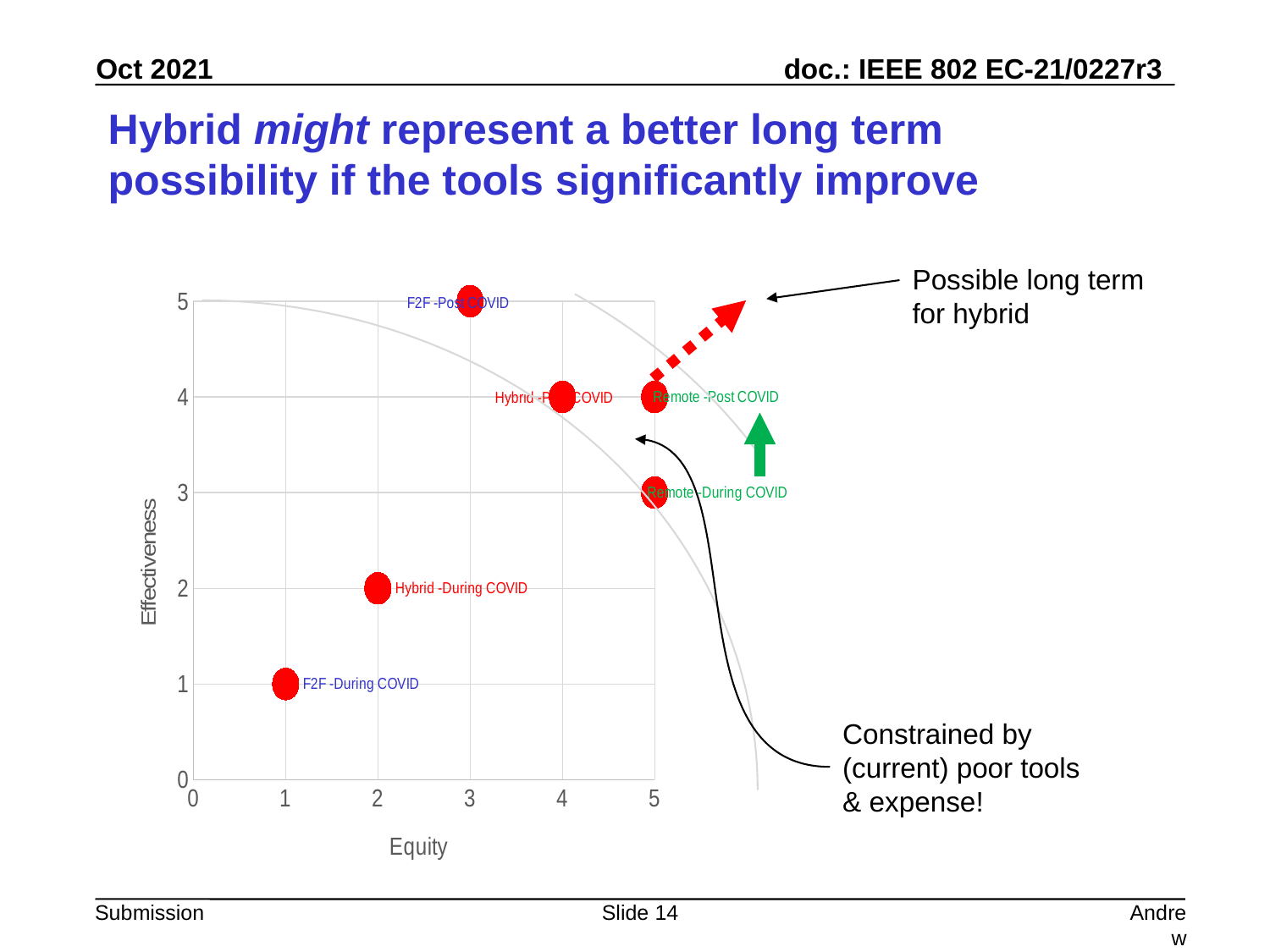
Which has the higher Effectiveness value, Hybrid -Post COVID or Hybrid -During COVID? Hybrid -Post COVID What is the Equity value for Hybrid -During COVID? 2 What is the Equity value for F2F -Post COVID? 3 Which point has the highest Effectiveness value? F2F -Post COVID What is the difference in Effectiveness between Remote -Post COVID and Remote -During COVID? 1 What is the label of the y axis? Effectiveness What is the Effectiveness value for Remote -During COVID? 3 How many data points are plotted on the chart? 6 What is the Effectiveness value for F2F -During COVID? 1 Which point has the lowest Equity value? F2F -During COVID What is the label of the x axis? Equity What kind of chart is shown on the slide? scatter chart